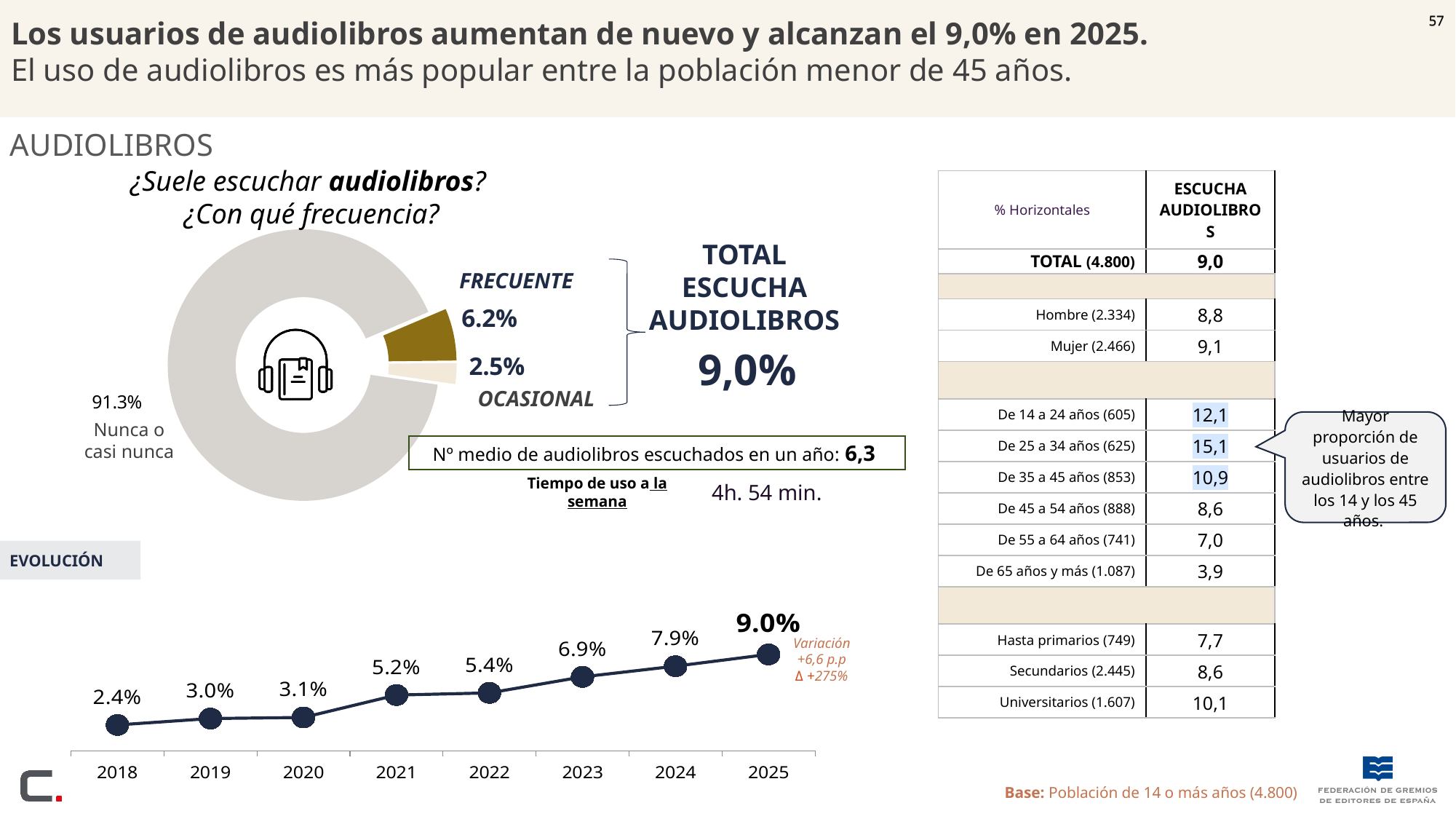
In the EVOLUCIÓN line chart at the bottom of the slide, which year has the lowest value? 2018 In the EVOLUCIÓN line chart at the bottom of the slide, what is the value for 2021? 5.2% In the EVOLUCIÓN line chart at the bottom of the slide, which year has the highest value? 2025 In the donut chart on the left, what is the value for FRECUENTE? 6.2% What kind of chart is the EVOLUCIÓN chart at the bottom of the slide? Line chart In the EVOLUCIÓN line chart at the bottom of the slide, is the value for 2023 larger than the value for 2022? Yes, 2023 (6.9%) is larger than 2022 (5.4%) In the EVOLUCIÓN line chart at the bottom of the slide, what is the value for 2025? 9.0% How many years are plotted in the EVOLUCIÓN line chart at the bottom of the slide? 8 In the EVOLUCIÓN line chart at the bottom of the slide, what is the difference between the 2025 value and the 2024 value? 1.1 percentage points In the EVOLUCIÓN line chart at the bottom of the slide, do the values rise or fall from 2018 to 2025? Rise In the EVOLUCIÓN line chart at the bottom of the slide, what is the value for 2018? 2.4% In the donut chart on the left, what share corresponds to 'Nunca o casi nunca'? 91.3%